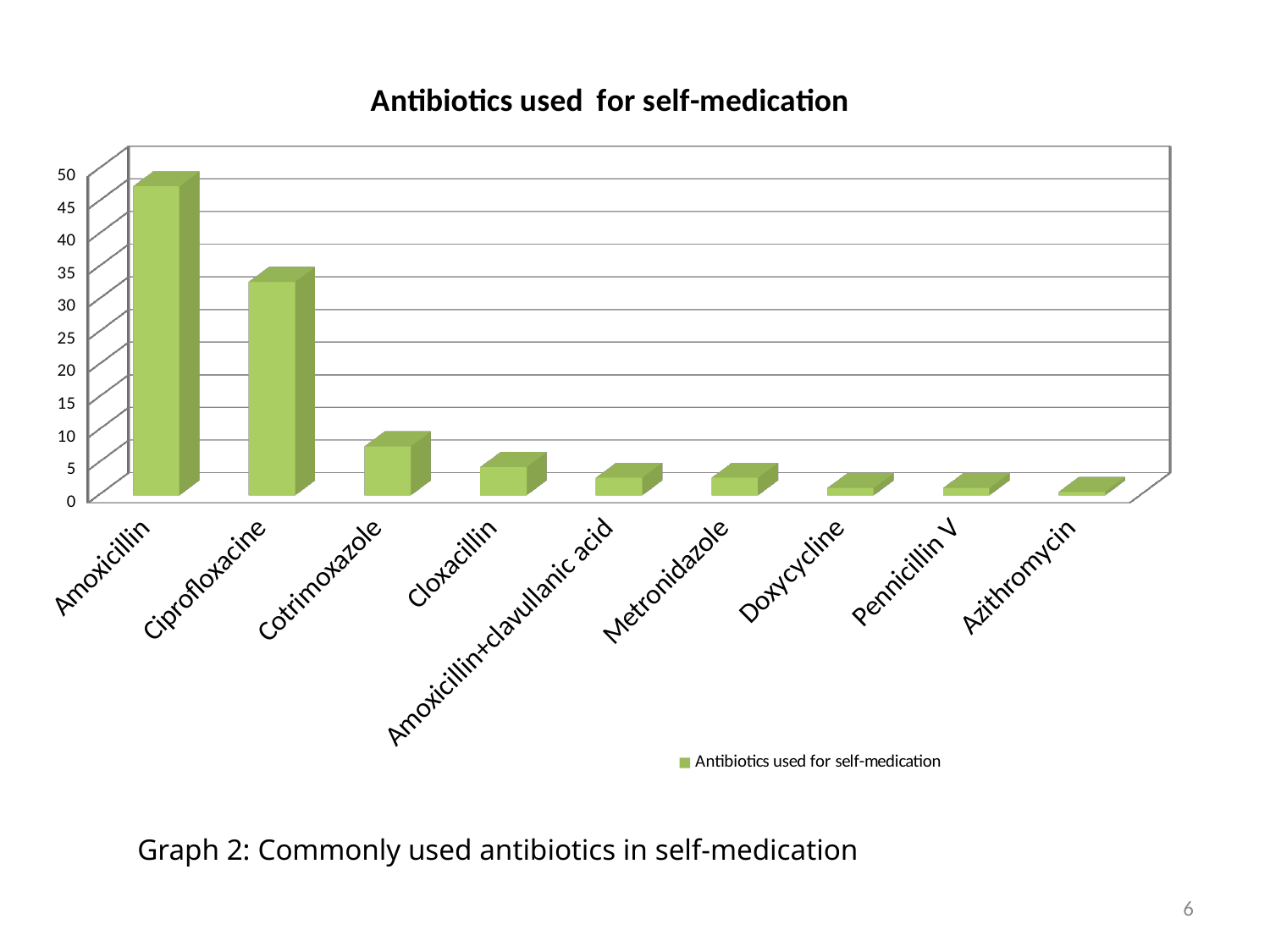
How many antibiotics (categories) are shown on the x axis? 9 What is the title of the chart? Antibiotics used for self-medication Is the value for Ciprofloxacine greater or less than 25? greater Which antibiotic has the highest value? Amoxicillin Is the value for Amoxicillin greater or less than 40? greater Is the value for Cotrimoxazole greater or less than 10? less What kind of chart is shown on the slide? Bar chart Do the values rise or fall moving from left to right along the x axis? Fall How many series does the legend list? 1 Which has a larger value, Amoxicillin or Ciprofloxacine? Amoxicillin Which has a larger value, Cotrimoxazole or Cloxacillin? Cotrimoxazole